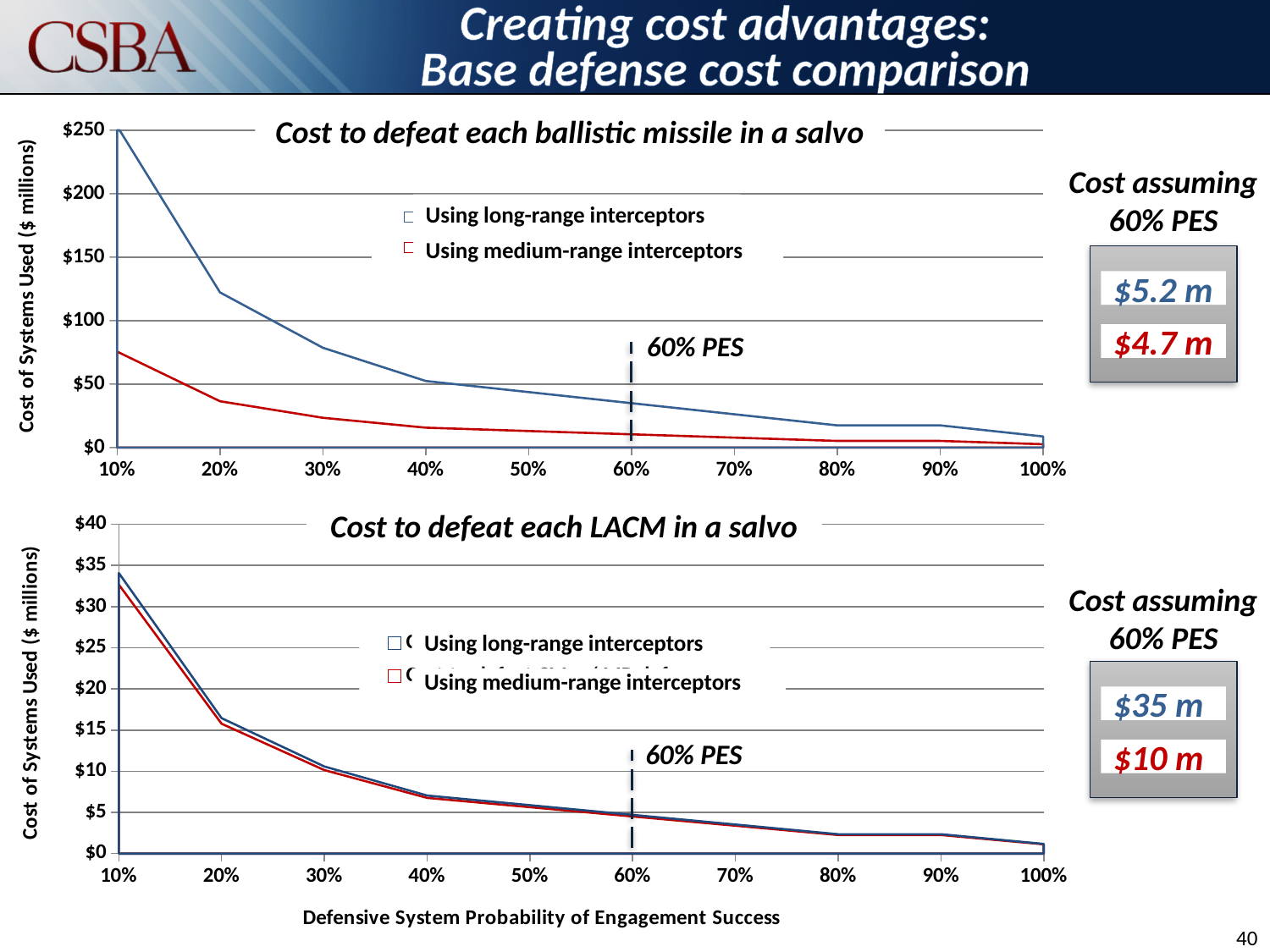
How many series does the legend of the top chart list? 2 In the top chart, is the cost using medium-range interceptors at 10% PES greater or less than $100? less What value is shown in the blue box under 'Cost assuming 60% PES' next to the top chart? $5.2 m In the top chart, is the cost using long-range interceptors at 10% PES greater or less than $200? greater In the top chart, at which PES value is the cost using long-range interceptors highest? 10% In the bottom chart, is the cost using long-range interceptors at 10% PES greater or less than $30? greater What is the x-axis title shown below the bottom chart? Defensive System Probability of Engagement Success In the top chart, do the costs rise or fall as the probability of engagement success increases? Fall In the top chart, at 20% PES, which is larger: the cost using long-range interceptors or the cost using medium-range interceptors? Using long-range interceptors What kind of chart is the top chart, 'Cost to defeat each ballistic missile in a salvo'? Line chart How many PES values are marked along the x axis of the bottom chart, 'Cost to defeat each LACM in a salvo'? 10